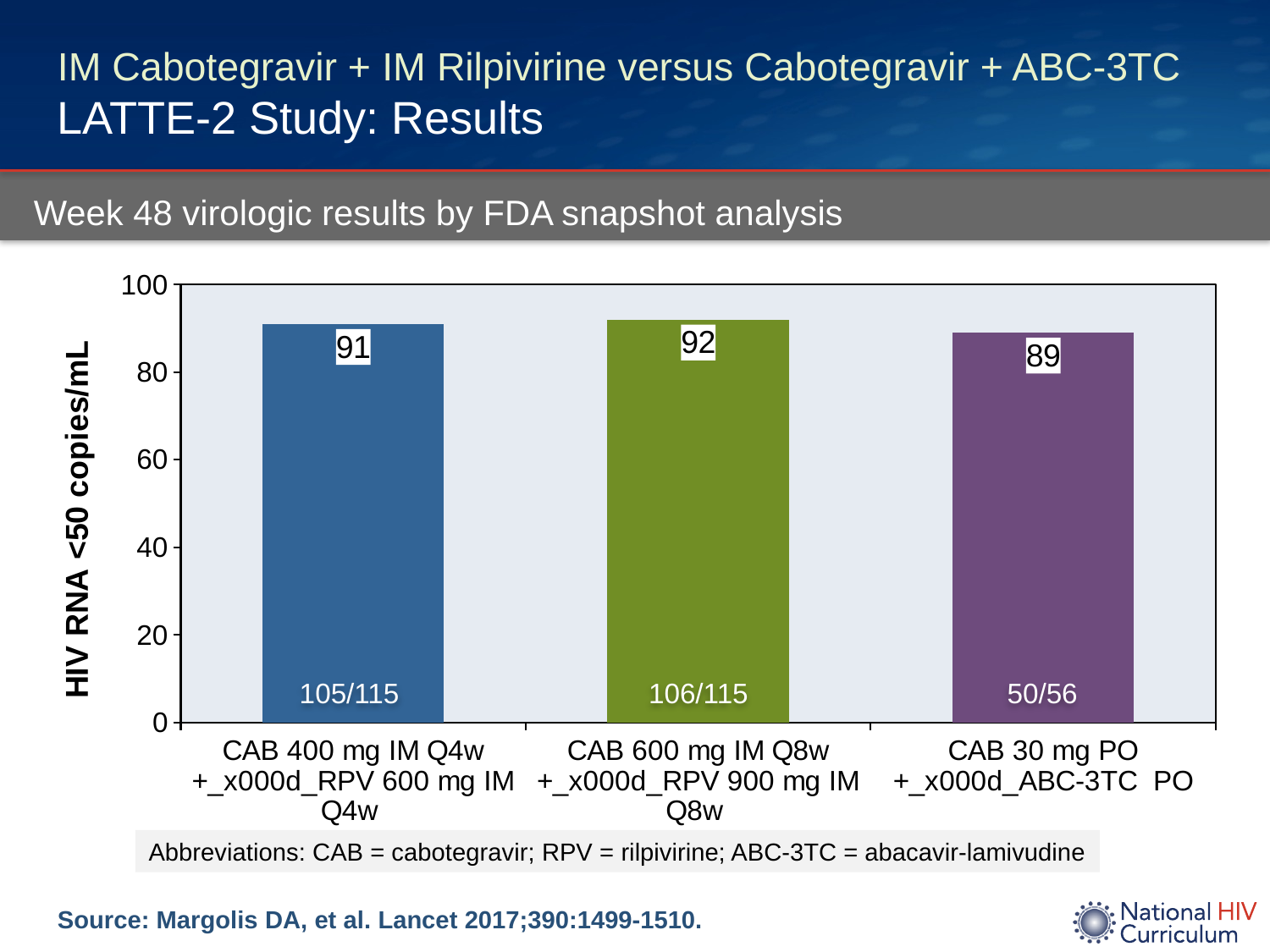
Which treatment arm has the highest value? CAB 600 mg IM Q8w + RPV 900 mg IM Q8w What kind of chart is shown on the slide? Bar chart What is the value for the CAB 400 mg IM Q4w + RPV 600 mg IM Q4w bar? 91 What fraction of participants is printed inside the CAB 30 mg PO + ABC-3TC PO bar? 50/56 What is the difference between the CAB 600 mg IM Q8w arm and the CAB 30 mg PO + ABC-3TC PO arm? 3 What is the value for the CAB 600 mg IM Q8w + RPV 900 mg IM Q8w bar? 92 What fraction of participants is printed inside the CAB 600 mg IM Q8w + RPV 900 mg IM Q8w bar? 106/115 Is the value for the CAB 30 mg PO + ABC-3TC PO arm greater or less than 80? greater What is the label of the vertical axis? HIV RNA <50 copies/mL Which treatment arm has the lowest value? CAB 30 mg PO + ABC-3TC PO What is the value for the CAB 30 mg PO + ABC-3TC PO bar? 89 How many treatment arms are shown in the chart? 3